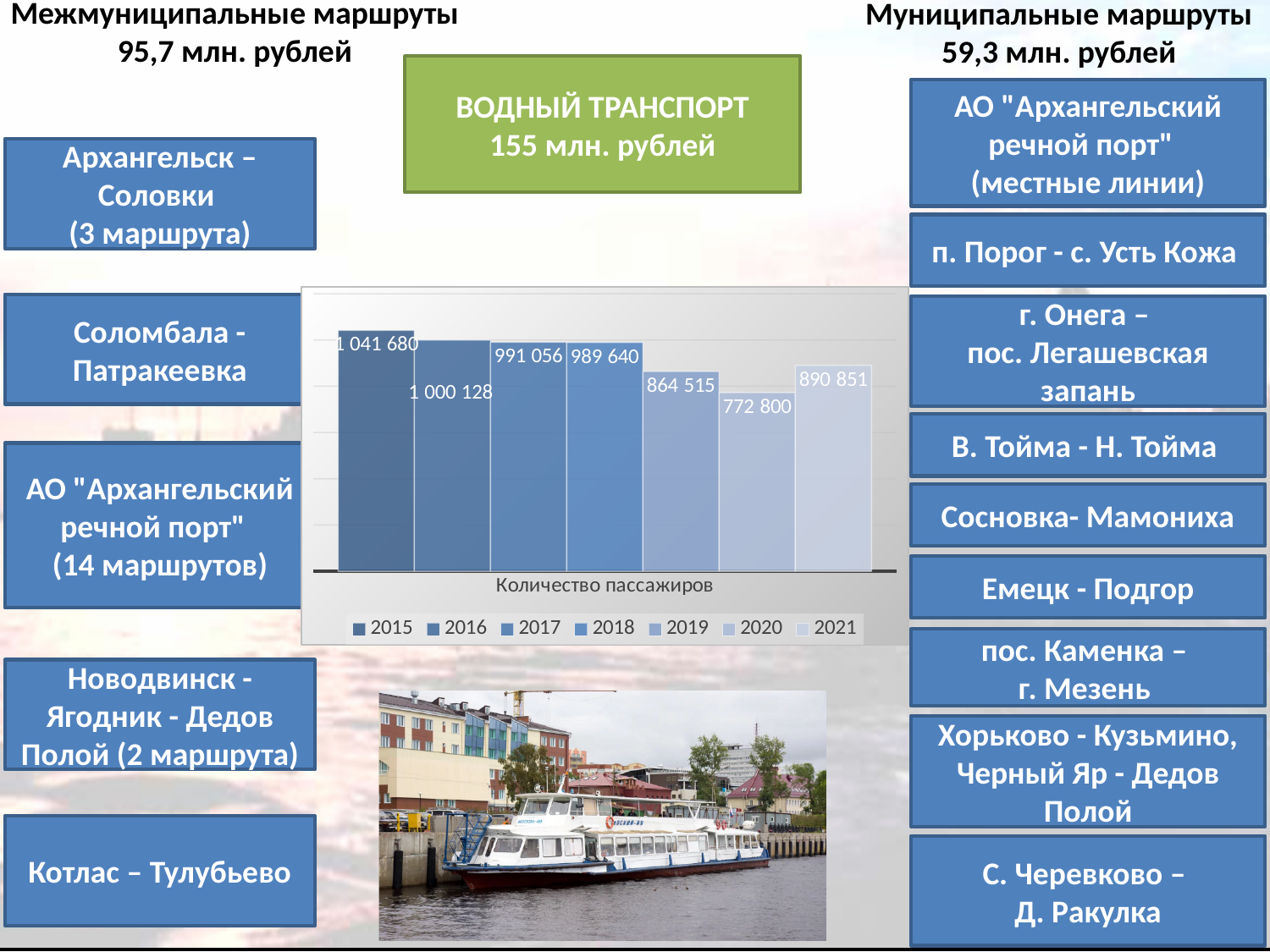
What is the number of passengers (Количество пассажиров) for 2015? 1 041 680 What is the difference in passengers between 2015 and 2016? 41 552 How many series does the legend list? 7 Which year has the highest number of passengers? 2015 What type of chart is shown on the slide? bar chart Which year has the lowest number of passengers? 2020 What is the number of passengers for 2020? 772 800 What is the difference in passengers between 2021 and 2020? 118 051 Which year had more passengers, 2019 or 2021? 2021 Do the passenger numbers rise or fall from 2015 to 2020? fall What is the number of passengers for 2018? 989 640 What is the number of passengers for 2021? 890 851